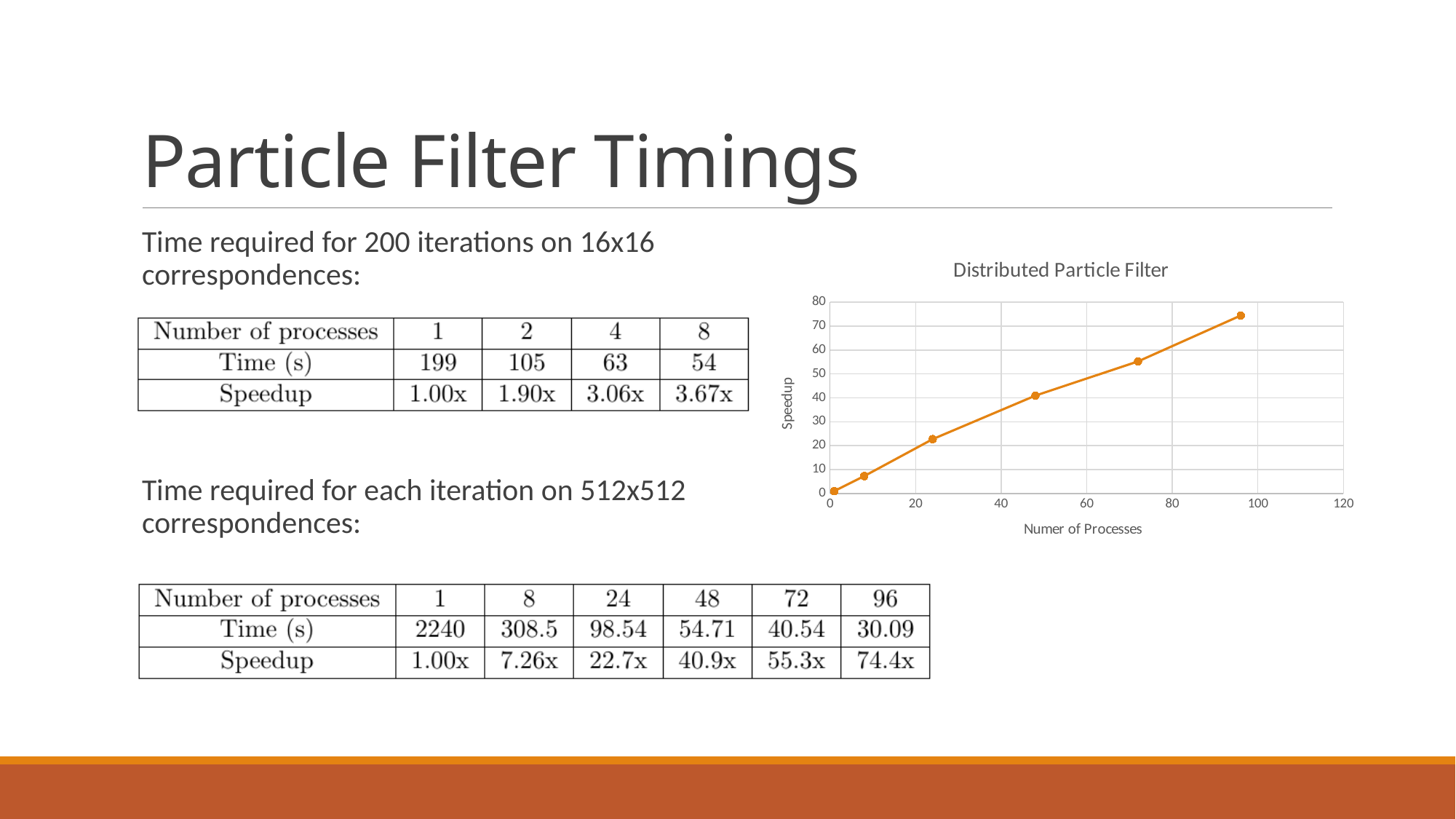
Is the speedup at 96 processes greater or less than 70? greater Is the speedup at 24 processes greater or less than 30? less Which has the larger speedup on the chart, 24 processes or 72 processes? 72 processes What is the title of the chart on the slide? Distributed Particle Filter Is the speedup at 48 processes greater or less than 50? less What is the label of the y axis of the chart? Speedup What kind of chart is shown on the slide? line chart How many data points are plotted on the chart? 6 Does the speedup rise or fall as the number of processes increases along the x axis? rise Which number of processes has the highest speedup on the chart? 96